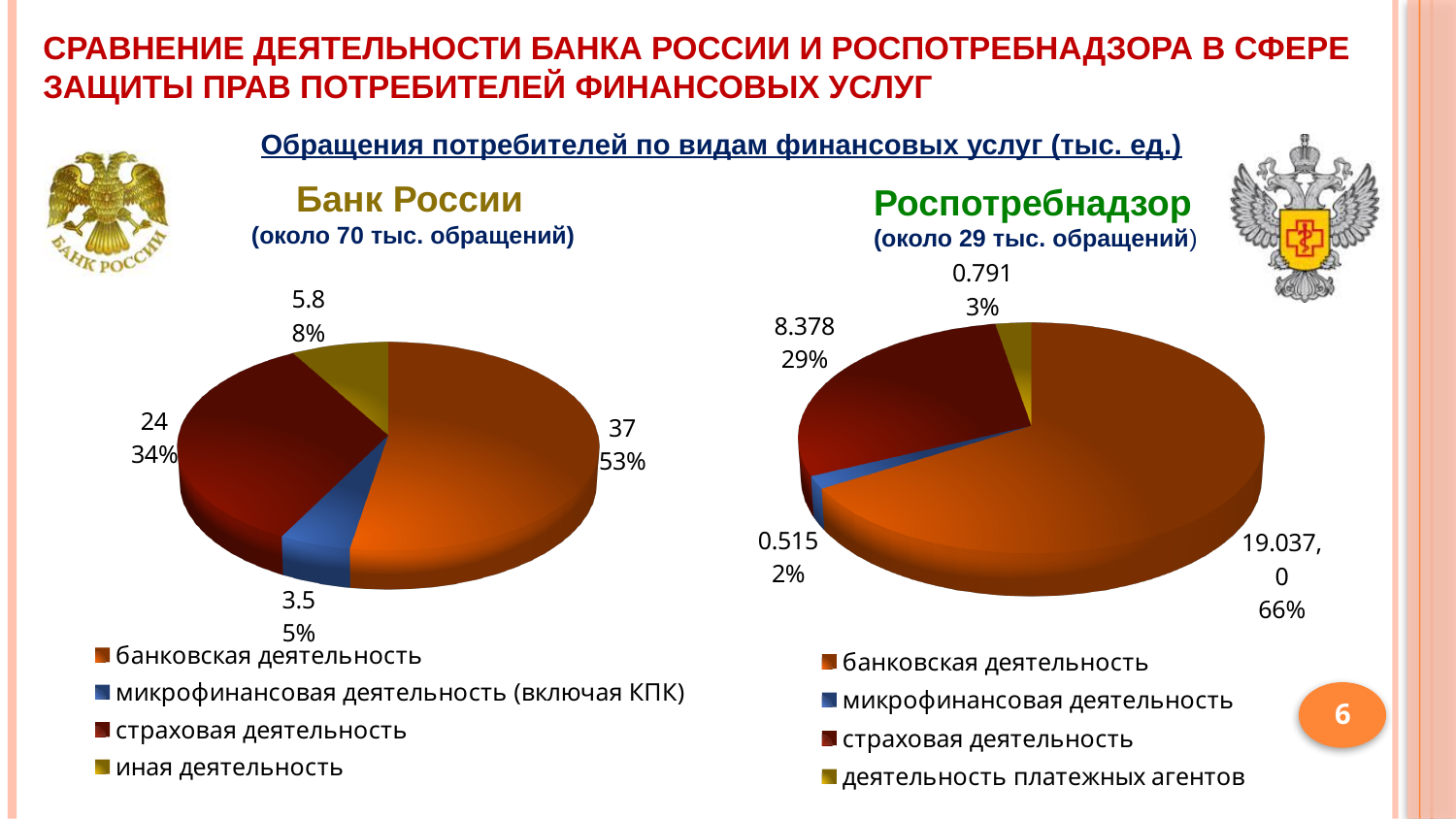
In the Банк России chart, what value is shown for банковская деятельность? 37 What is the title shown above both charts? Обращения потребителей по видам финансовых услуг (тыс. ед.) In the Банк России chart, what share of the pie is страховая деятельность? 34% In the Банк России chart, what is the difference between the values for банковская деятельность and страховая деятельность? 13 In the Роспотребнадзор chart, which category has the smallest slice? микрофинансовая деятельность In the Банк России chart, which category has the smallest slice? микрофинансовая деятельность (включая КПК) What kind of chart is used for the Банк России data? pie chart How many categories does the legend of the Роспотребнадзор chart list? 4 In the Банк России chart, what value is shown for иная деятельность? 5.8 In the Роспотребнадзор chart, which is larger: деятельность платежных агентов or микрофинансовая деятельность? деятельность платежных агентов In the Роспотребнадзор chart, what share of the pie is банковская деятельность? 66% In the Роспотребнадзор chart, what value is shown for страховая деятельность? 8.378